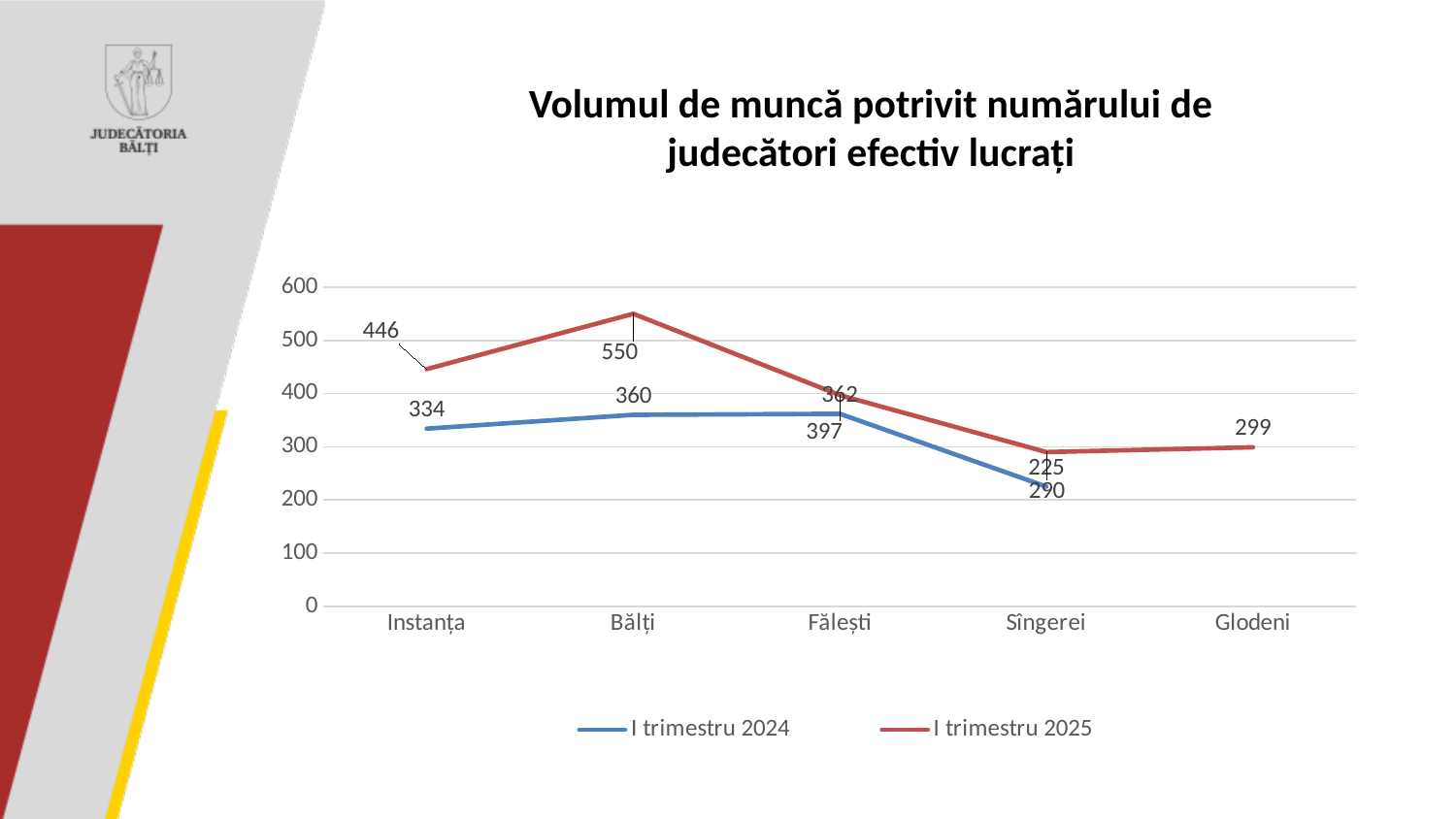
How many series does the legend list? 2 How many categories are shown on the x axis? 5 What is the value for Glodeni in the I trimestru 2025 series? 299 Which category has the lowest value in the I trimestru 2024 series? Sîngerei Does the I trimestru 2025 series rise or fall from Bălți to Sîngerei? Fall What is the value for Instanța in the I trimestru 2025 series? 446 What type of chart is shown on the slide? Line chart What is the value for Instanța in the I trimestru 2024 series? 334 Which is larger in the I trimestru 2025 series: Instanța or Bălți? Bălți What is the value for Bălți in the I trimestru 2025 series? 550 Which category has the highest value in the I trimestru 2025 series? Bălți What is the difference between the I trimestru 2025 and I trimestru 2024 values for Bălți? 190